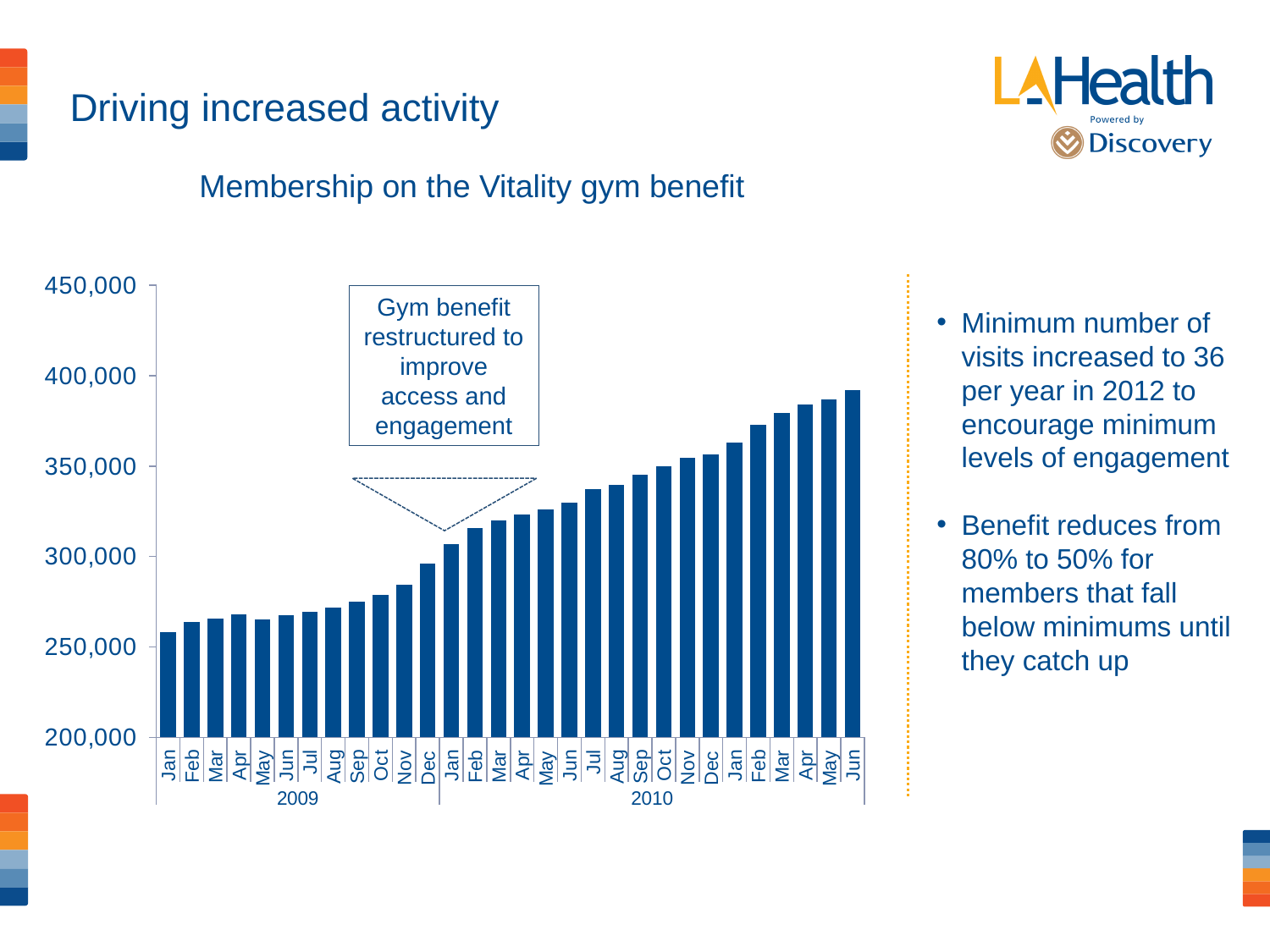
Do the membership values generally rise or fall from left to right along the x axis? rise Is the value for Jan 2010 greater or less than 300,000? greater What is the title of the chart? Membership on the Vitality gym benefit Is the value for Dec 2010 greater or less than 350,000? greater How many bars are plotted in the chart? 30 Which month has the lowest membership value in the chart? Jan 2009 Which is larger, the value for Dec 2009 or the value for Jan 2009? Dec 2009 Which bar has the highest membership value in the chart? the last Jun bar at the right end of the axis Is the value for Jan 2009 greater or less than 300,000? less What kind of chart is shown on the slide? bar chart What does the callout box above the chart say? Gym benefit restructured to improve access and engagement